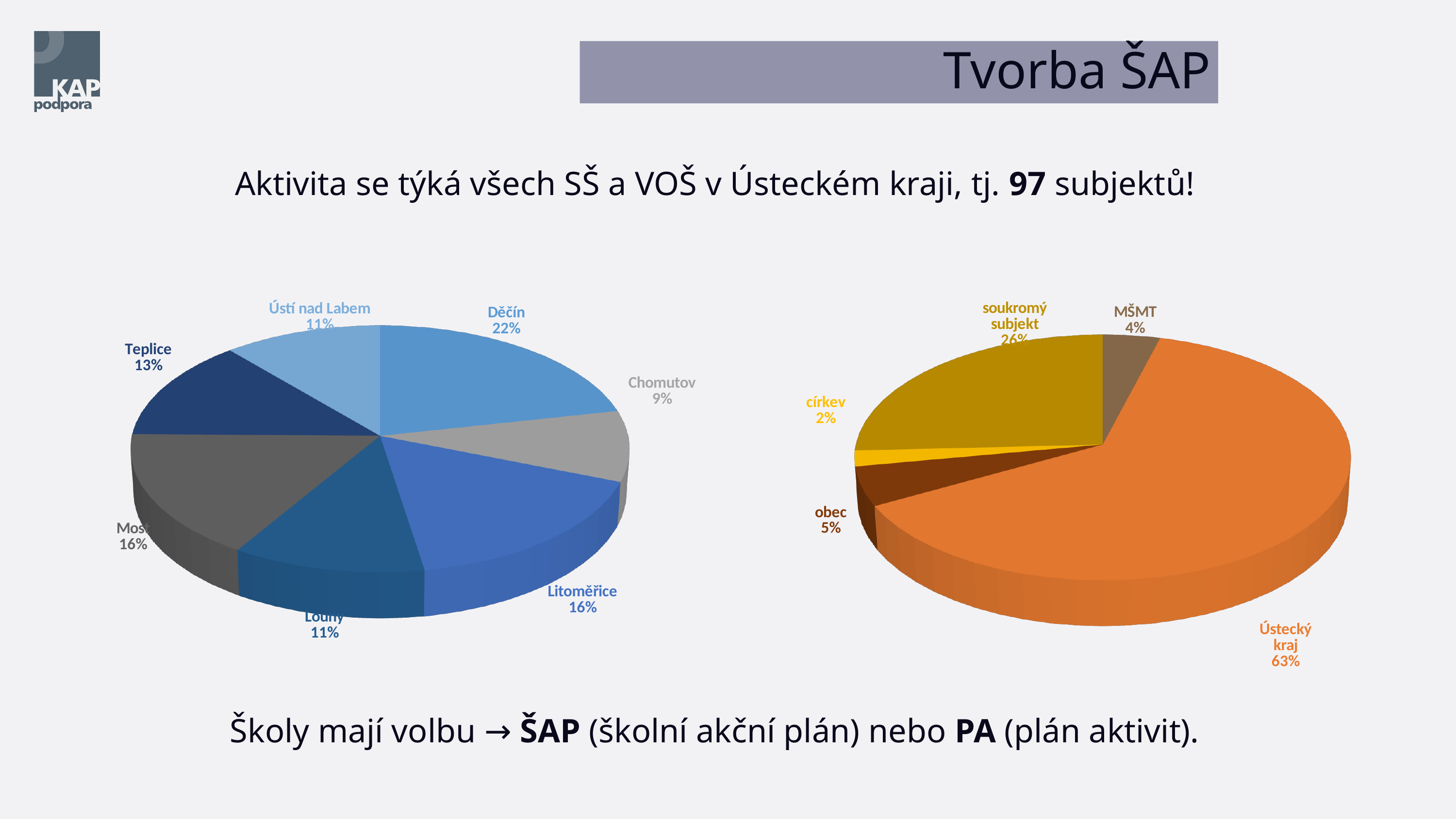
In the left pie chart, which is larger, the share of Most or the share of Louny? Most In the left pie chart, what share does Chomutov have? 9% In the left pie chart, which category has the smallest share? Chomutov How many slices does the left pie chart have? 7 In the left pie chart, which category has the largest share? Děčín In the right pie chart, what is the difference between the shares of obec and MŠMT? 1% In the left pie chart, what is the difference between the shares of Děčín and Teplice? 9% What type of chart is shown on the right side of the slide? Pie chart In the left pie chart, what share does Děčín have? 22% In the right pie chart, what share does soukromý subjekt have? 26% In the right pie chart, which category has the smallest share? církev In the right pie chart, what share does Ústecký kraj have? 63%